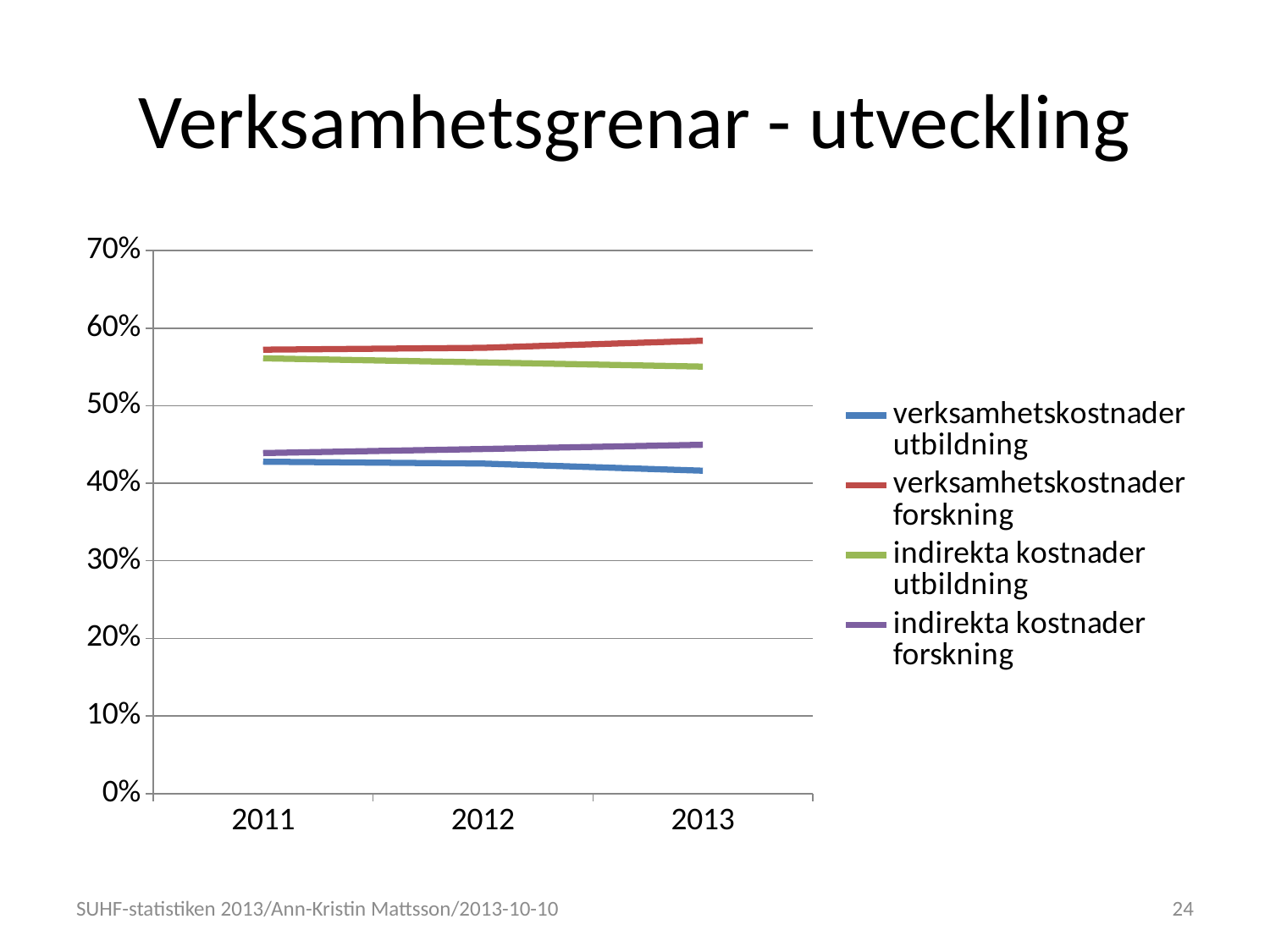
Is the value for verksamhetskostnader utbildning in 2013 greater or less than 50%? less What kind of chart is shown on the slide? line chart Which series has the lowest value in 2013? verksamhetskostnader utbildning Which series is drawn in red? verksamhetskostnader forskning How many years are shown on the x axis? 3 How many series does the legend list? 4 Which series has the highest value in 2013? verksamhetskostnader forskning Does the value for indirekta kostnader utbildning rise or fall from 2011 to 2013? fall Does the value for verksamhetskostnader forskning rise or fall from 2011 to 2013? rise Is the value for verksamhetskostnader forskning in 2013 greater or less than 50%? greater What is the title of the slide? Verksamhetsgrenar - utveckling Is the value for indirekta kostnader forskning in 2011 greater or less than 40%? greater